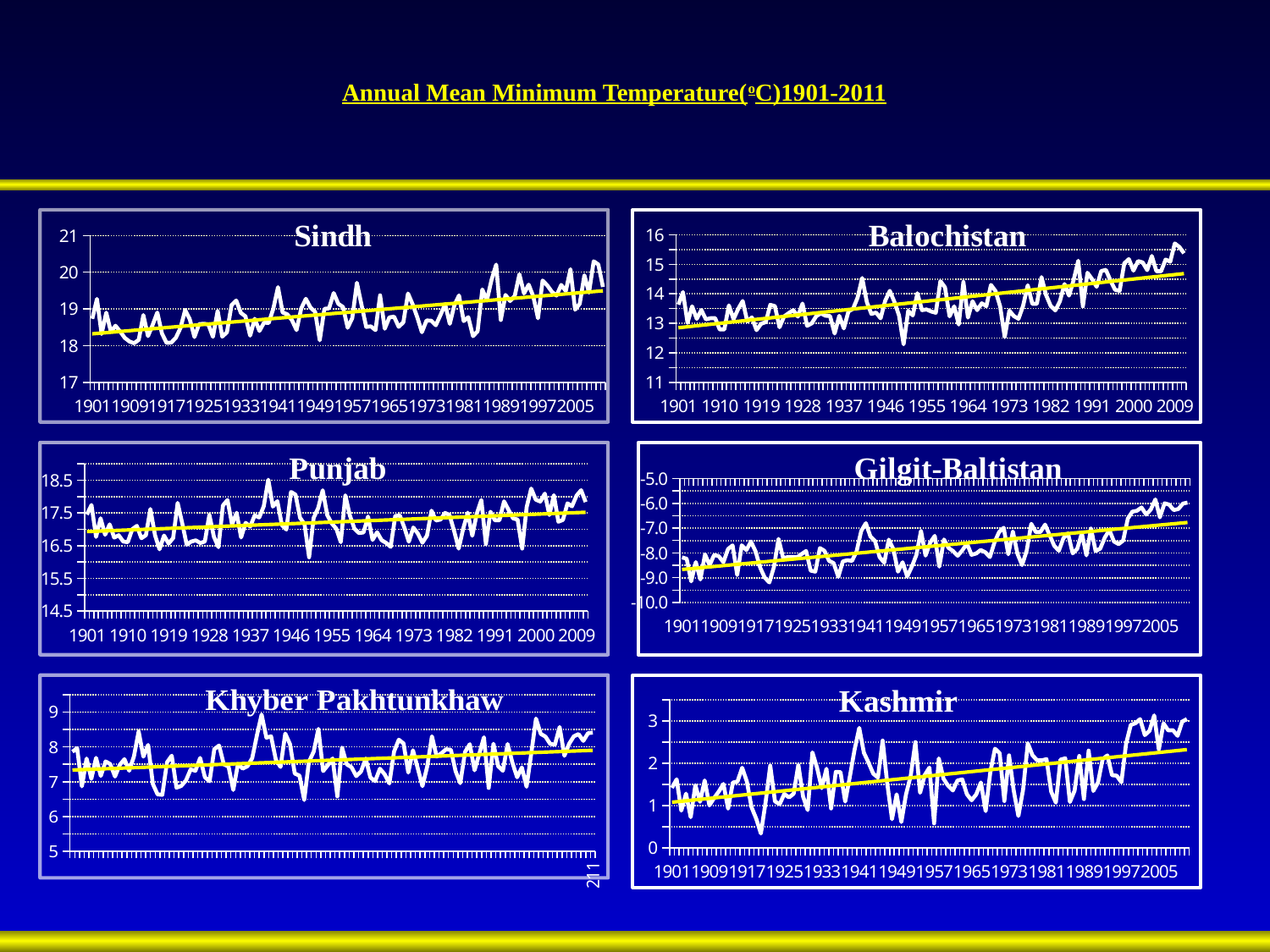
In the Kashmir chart, is the value for 2009 greater or less than 2? greater In the Kashmir chart, does the trend line rise or fall from 1901 to 2011? rise In the Punjab chart, does the trend line rise or fall over the period? rise What kind of chart is the Sindh chart? line chart In the Balochistan chart, does the trend line rise or fall over the period? rise In the Gilgit-Baltistan chart, is the value for 1901 greater or less than -7.0? less What is the title of the slide's set of charts? Annual Mean Minimum Temperature(°C)1901-2011 How many charts are shown on the slide? 6 In the Balochistan chart, is the value for 2009 greater or less than 14? greater